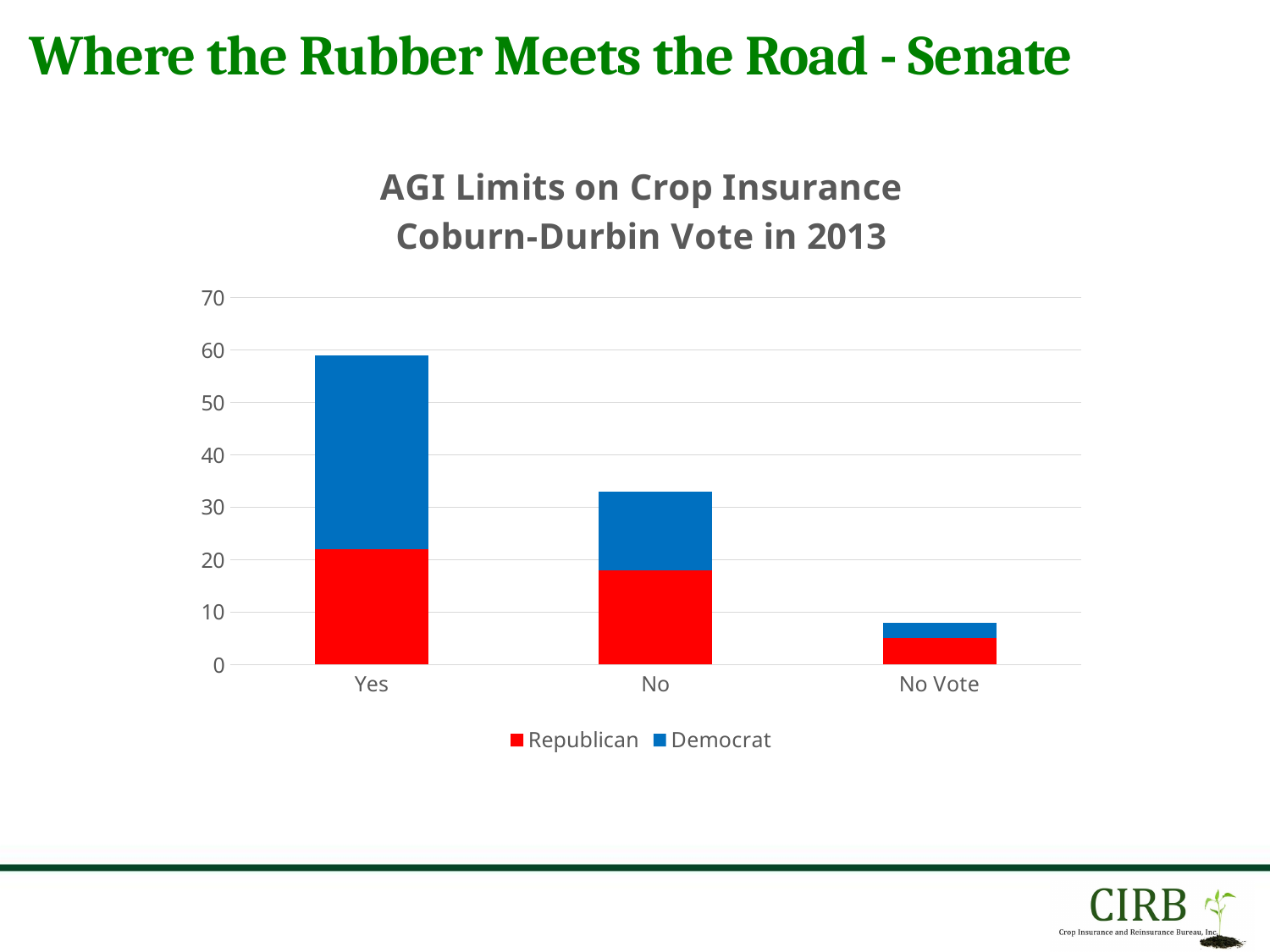
Which category has the shortest stacked bar? No Vote What kind of chart is shown on the slide? bar chart Is the total stacked bar for No greater or less than 40? less Which category has the tallest stacked bar? Yes Which is larger, the Democrat portion of the Yes bar or the Democrat portion of the No bar? Yes Is the total stacked bar for Yes greater or less than 50? greater Is the total stacked bar for No Vote greater or less than 10? less Which series is shown in red in the chart? Republican How many series does the chart's legend list? 2 What is the title of the chart? AGI Limits on Crop Insurance Coburn-Durbin Vote in 2013 How many categories are shown on the x axis of the chart? 3